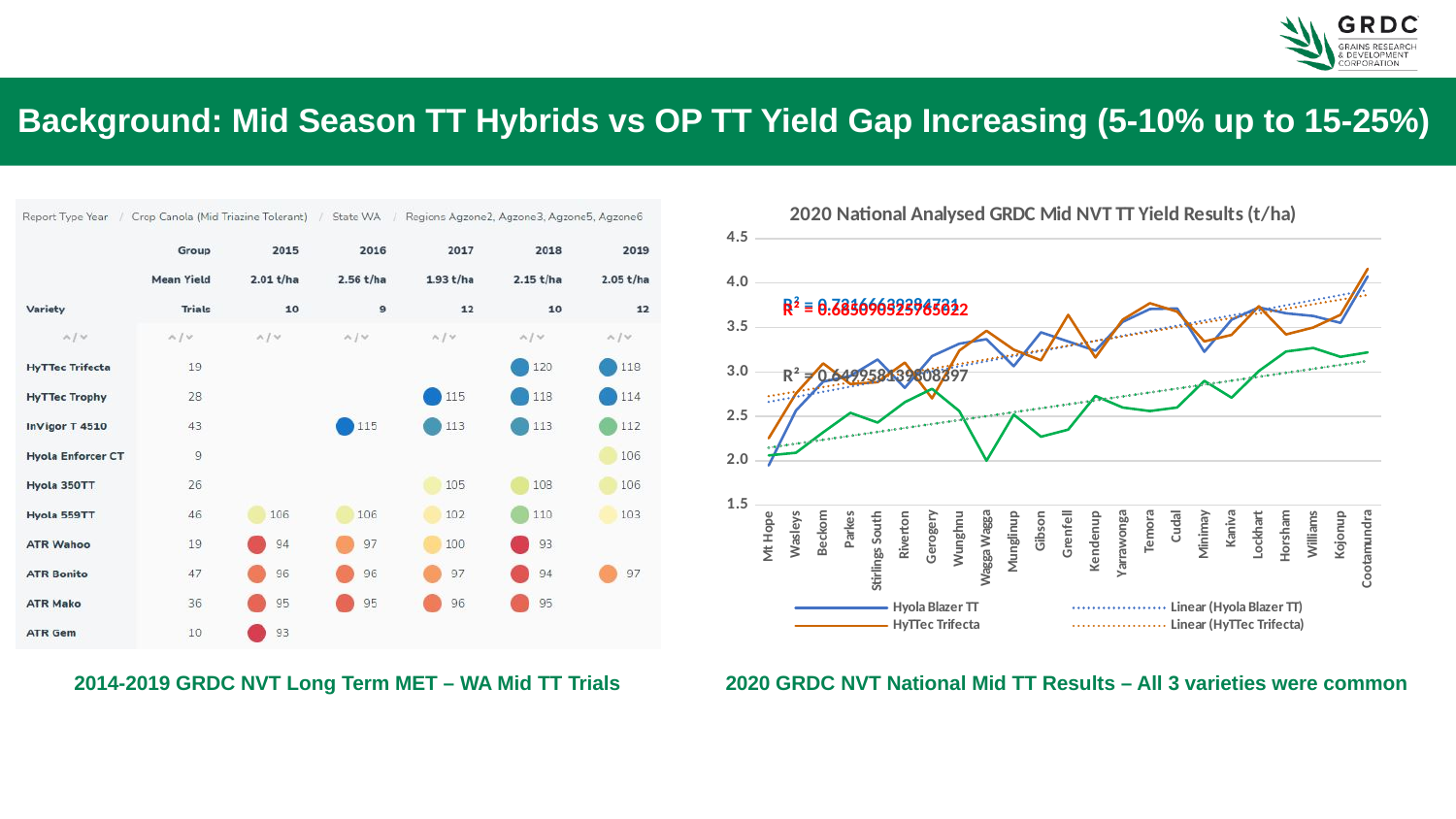
In the 2020 National Analysed GRDC Mid NVT TT Yield Results chart, is the HyTTec Trifecta value at Cootamundra greater or less than 4.0? greater What is the title of the chart on the right of the slide? 2020 National Analysed GRDC Mid NVT TT Yield Results (t/ha) In the 2020 National Analysed GRDC Mid NVT TT Yield Results chart, at which site is the Hyola Blazer TT yield highest? Cootamundra How many sites are listed along the x axis of the 2020 National Analysed GRDC Mid NVT TT Yield Results chart? 23 In the 2020 National Analysed GRDC Mid NVT TT Yield Results chart, do the yields generally rise or fall moving from Mt Hope to Cootamundra along the x axis? rise What kind of chart is shown on the right of the slide? line chart How many entries does the legend of the 2020 National Analysed GRDC Mid NVT TT Yield Results chart list? 4 In the 2020 National Analysed GRDC Mid NVT TT Yield Results chart, is the HyTTec Trifecta value at Grenfell greater or less than 3.5? greater In the 2020 National Analysed GRDC Mid NVT TT Yield Results chart, is the Hyola Blazer TT value at Mt Hope greater or less than 2.5? less In the 2020 National Analysed GRDC Mid NVT TT Yield Results chart, at which site is the Hyola Blazer TT yield lowest? Mt Hope In the 2020 National Analysed GRDC Mid NVT TT Yield Results chart, which is larger at Mt Hope: Hyola Blazer TT or HyTTec Trifecta? HyTTec Trifecta